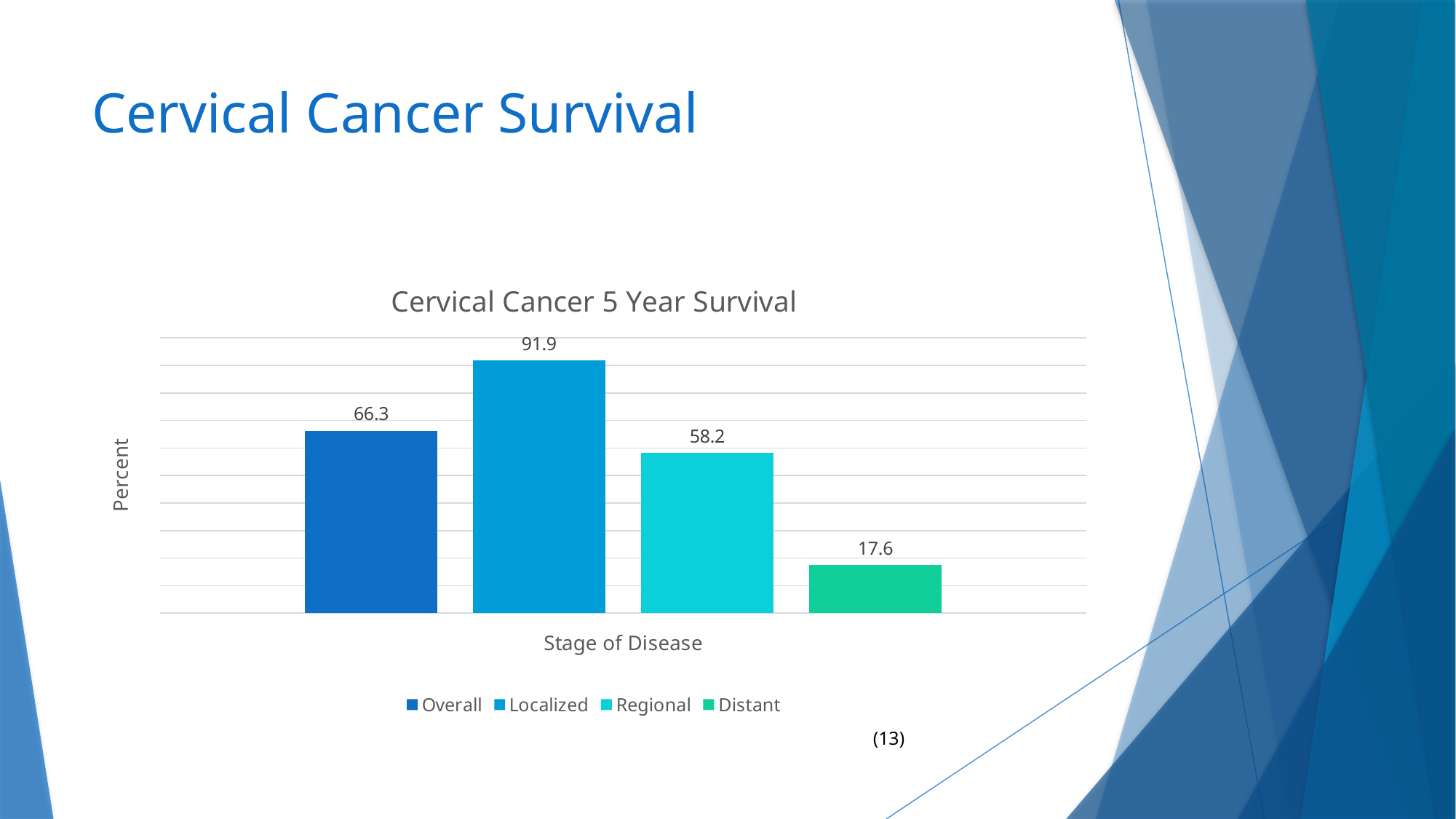
Which stage has the highest 5 year survival? Localized How many entries does the legend list? 4 What is the value shown for Regional? 58.2 What is the value shown for Overall? 66.3 What is the value shown for Distant? 17.6 What is the difference between the Localized and Distant values? 74.3 What is the 5 year survival value for Localized? 91.9 Which is larger, the value for Overall or the value for Regional? Overall What is the difference between the Overall and Regional values? 8.1 Which stage has the lowest 5 year survival? Distant What type of chart is shown on the slide? Bar chart How many bars are plotted in the chart? 4